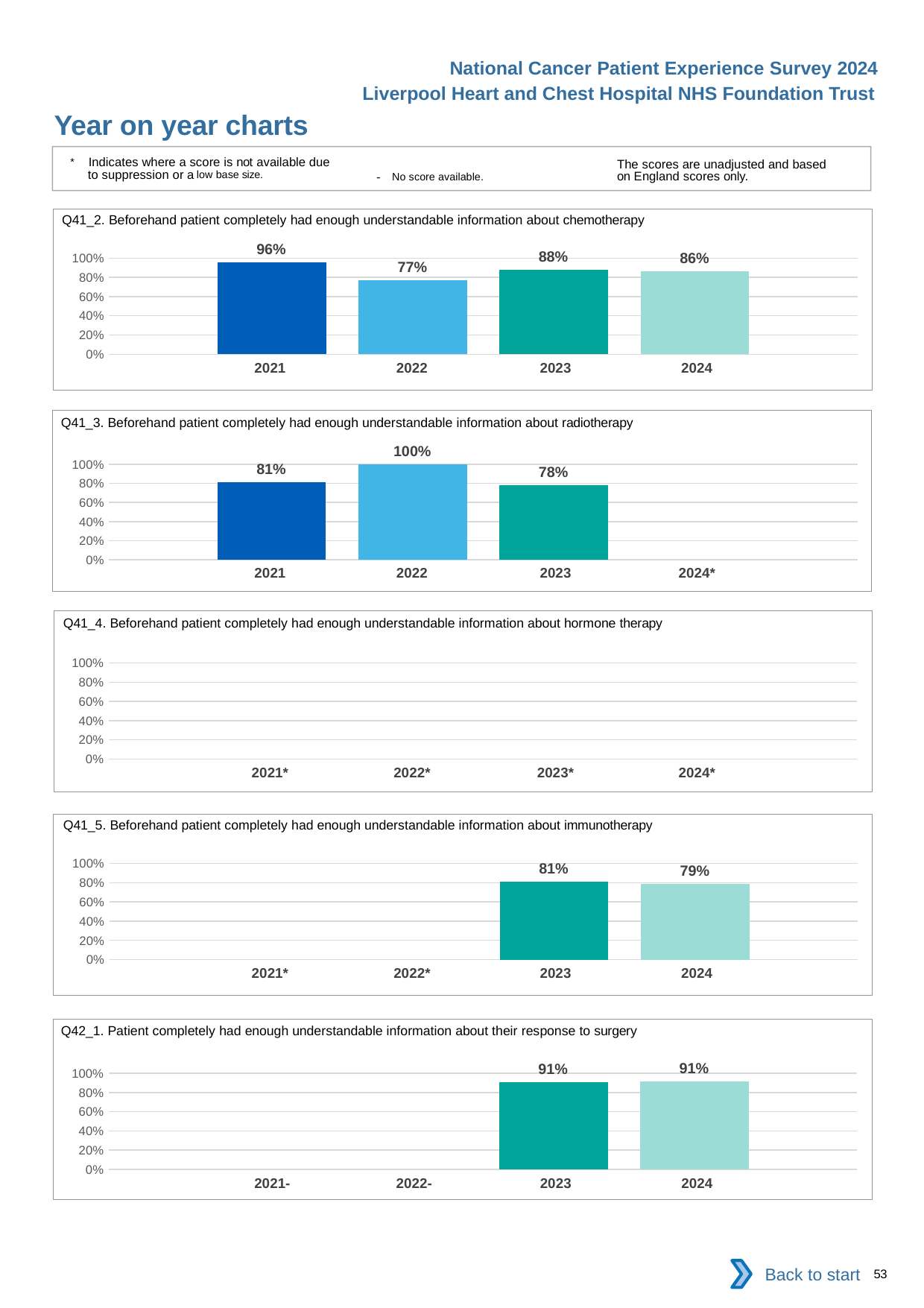
In the Q41_3 chart (radiotherapy), which year has the highest value? 2022 In the Q41_3 chart (radiotherapy), how many bars are plotted? 3 In the Q41_5 chart (immunotherapy), what is the value for 2024? 79% In the Q41_2 chart (chemotherapy), what is the difference between the 2023 and 2024 values? 2% In the Q42_1 chart (response to surgery), what is the value for 2023? 91% In the Q41_5 chart (immunotherapy), which is larger, the 2023 value or the 2024 value? 2023 In the Q41_4 chart (hormone therapy), how many bars are plotted? 0 In the Q41_3 chart (radiotherapy), what is the value for 2022? 100% In the Q42_1 chart (response to surgery), what is the difference between the 2023 and 2024 values? 0% In the Q41_2 chart (chemotherapy), what is the value for 2021? 96% What kind of chart is the Q41_2 chart (chemotherapy)? Bar chart In the Q41_2 chart (chemotherapy), which year has the lowest value? 2022